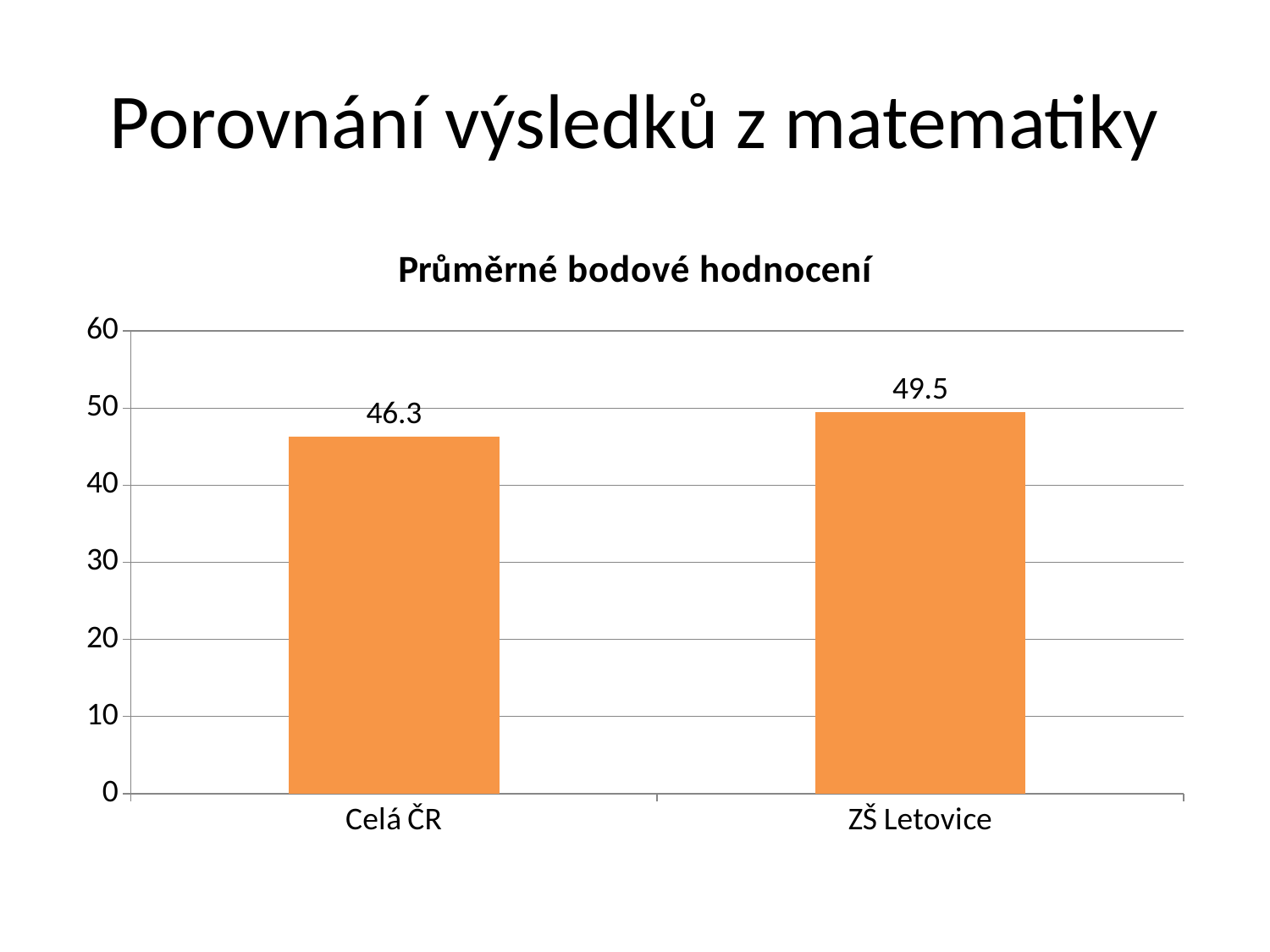
Which category has the highest value? ZŠ Letovice Which is larger, the value for Celá ČR or the value for ZŠ Letovice? ZŠ Letovice Which category has the lowest value? Celá ČR What colour are the bars in the chart? orange What is the title of the chart? Průměrné bodové hodnocení Is the value for Celá ČR greater or less than 50? less What is the value for Celá ČR? 46.3 How many categories are shown on the x axis? 2 Is the value for ZŠ Letovice greater or less than 40? greater What is the difference between the values for ZŠ Letovice and Celá ČR? 3.2 What is the value for ZŠ Letovice? 49.5 What kind of chart is shown on the slide? bar chart